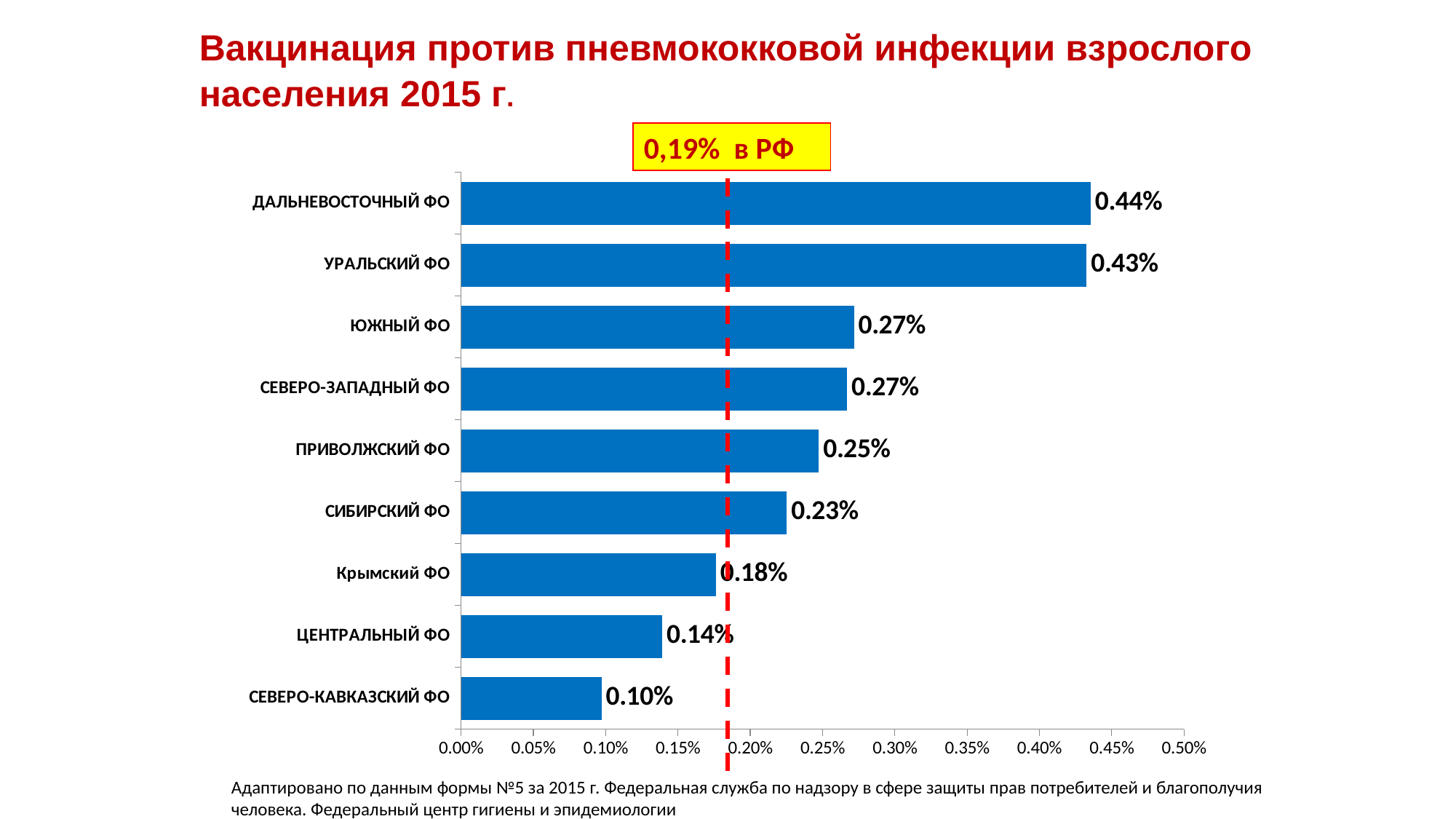
Which is larger, the value for ПРИВОЛЖСКИЙ ФО or the value for СИБИРСКИЙ ФО? ПРИВОЛЖСКИЙ ФО What is the value for СИБИРСКИЙ ФО? 0.23% How many federal districts are shown in the chart? 9 Which federal district has the lowest value? СЕВЕРО-КАВКАЗСКИЙ ФО What is the value for Крымский ФО? 0.18% Which federal district has the highest value? ДАЛЬНЕВОСТОЧНЫЙ ФО What is the difference between the values for УРАЛЬСКИЙ ФО and ЦЕНТРАЛЬНЫЙ ФО? 0.29% What kind of chart is shown on the slide? bar chart Is the value for ЮЖНЫЙ ФО greater or less than 0.20%? greater What is the difference between the values for ДАЛЬНЕВОСТОЧНЫЙ ФО and СЕВЕРО-КАВКАЗСКИЙ ФО? 0.34% What is the value for ДАЛЬНЕВОСТОЧНЫЙ ФО? 0.44% What value for the Russian Federation (РФ) is shown in the yellow box above the chart? 0,19%